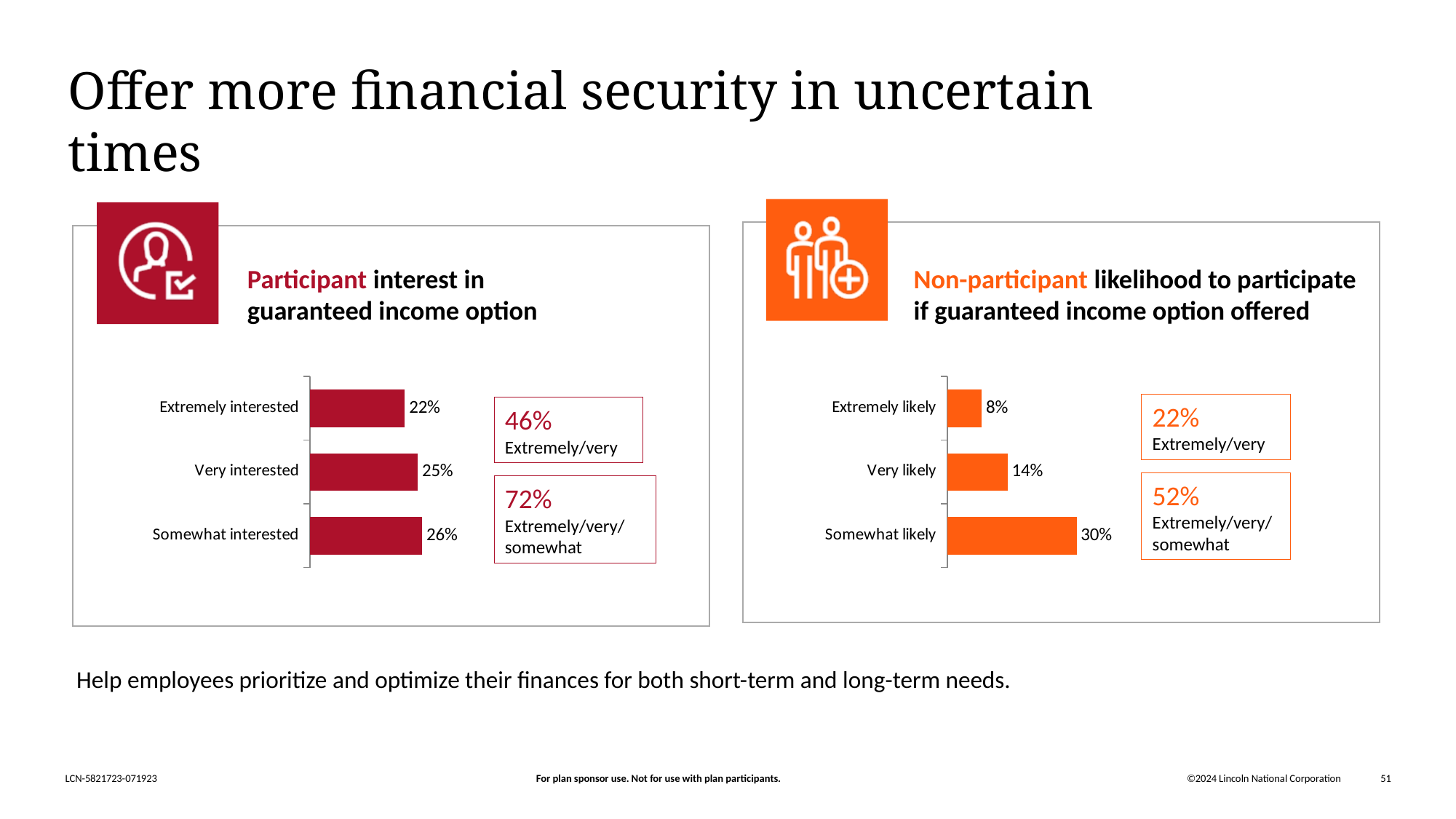
In the 'Participant interest in guaranteed income option' chart, what is the value for 'Very interested'? 25% In the 'Participant interest in guaranteed income option' chart, what combined percentage is shown in the box for 'Extremely/very/somewhat'? 72% In the 'Non-participant likelihood to participate if guaranteed income option offered' chart, which category has the lowest value? Extremely likely In the 'Non-participant likelihood to participate if guaranteed income option offered' chart, what is the value for 'Extremely likely'? 8% What type of chart is the 'Non-participant likelihood to participate if guaranteed income option offered' chart? Bar chart In the 'Participant interest in guaranteed income option' chart, how many categories are shown? 3 In the 'Participant interest in guaranteed income option' chart, what is the value for 'Extremely interested'? 22% In the 'Non-participant likelihood to participate if guaranteed income option offered' chart, what is the difference between 'Somewhat likely' and 'Very likely'? 16% In the 'Participant interest in guaranteed income option' chart, what is the difference between 'Somewhat interested' and 'Extremely interested'? 4% In the 'Non-participant likelihood to participate if guaranteed income option offered' chart, what is the value for 'Somewhat likely'? 30% In the 'Participant interest in guaranteed income option' chart, which category has the highest value? Somewhat interested Which is larger: 'Very interested' in the participant chart or 'Very likely' in the non-participant chart? Very interested